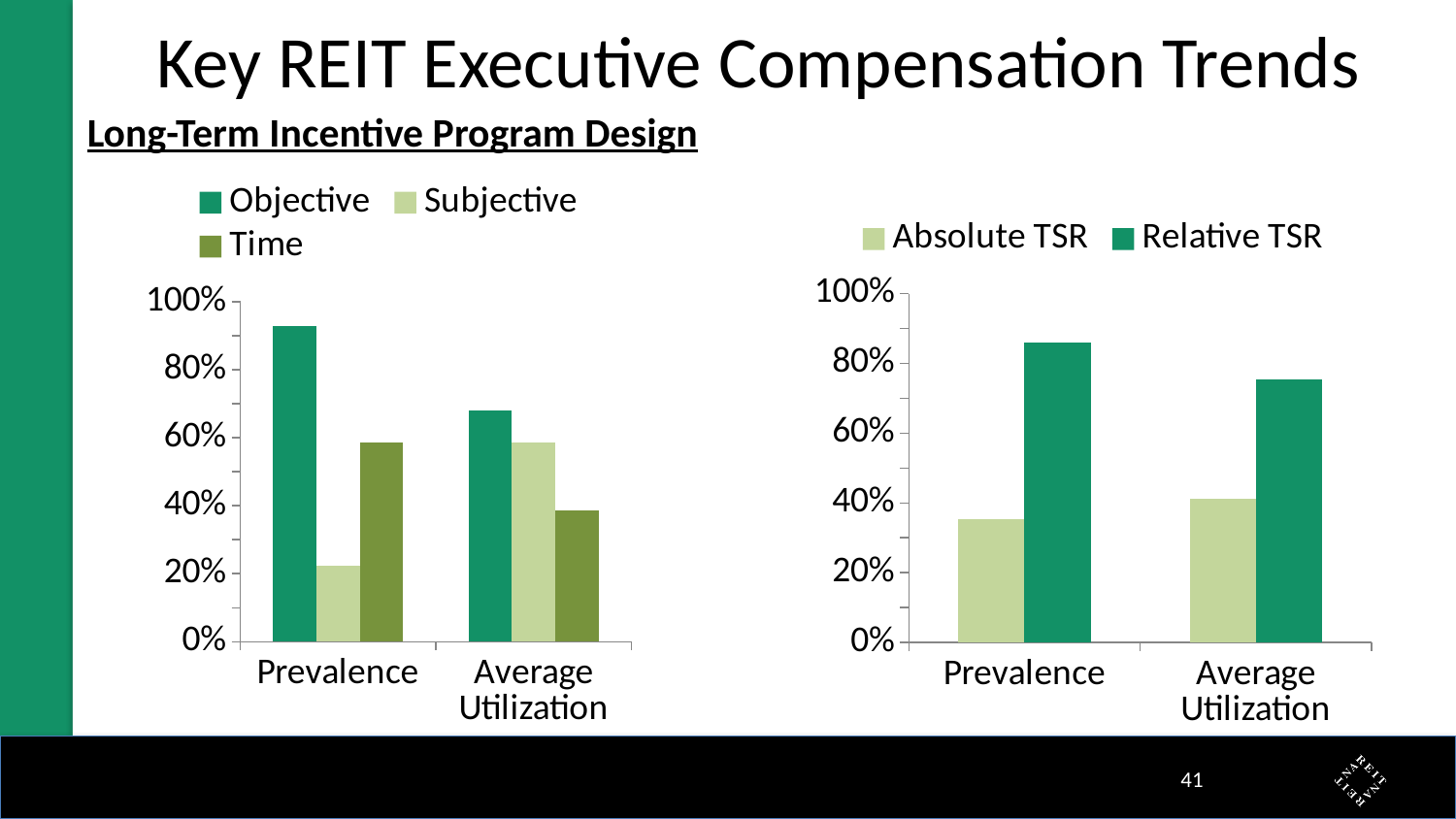
In the left chart, is the Subjective value for Prevalence greater or less than 40%? less In the left chart, which series has the lowest value for Average Utilization? Time In the left chart, how many series does the legend list? 3 In the left chart, which series has the lowest value for Prevalence? Subjective What kind of chart is the left chart? Bar chart In the right chart, which series has the higher value for Prevalence, Absolute TSR or Relative TSR? Relative TSR In the left chart, which series has the highest value for Prevalence? Objective In the right chart, is the Relative TSR value for Average Utilization greater or less than 60%? greater In the right chart, is the Absolute TSR value for Prevalence greater or less than 40%? less How many categories are shown on the x axis of the right chart? 2 In the right chart, how many series does the legend list? 2